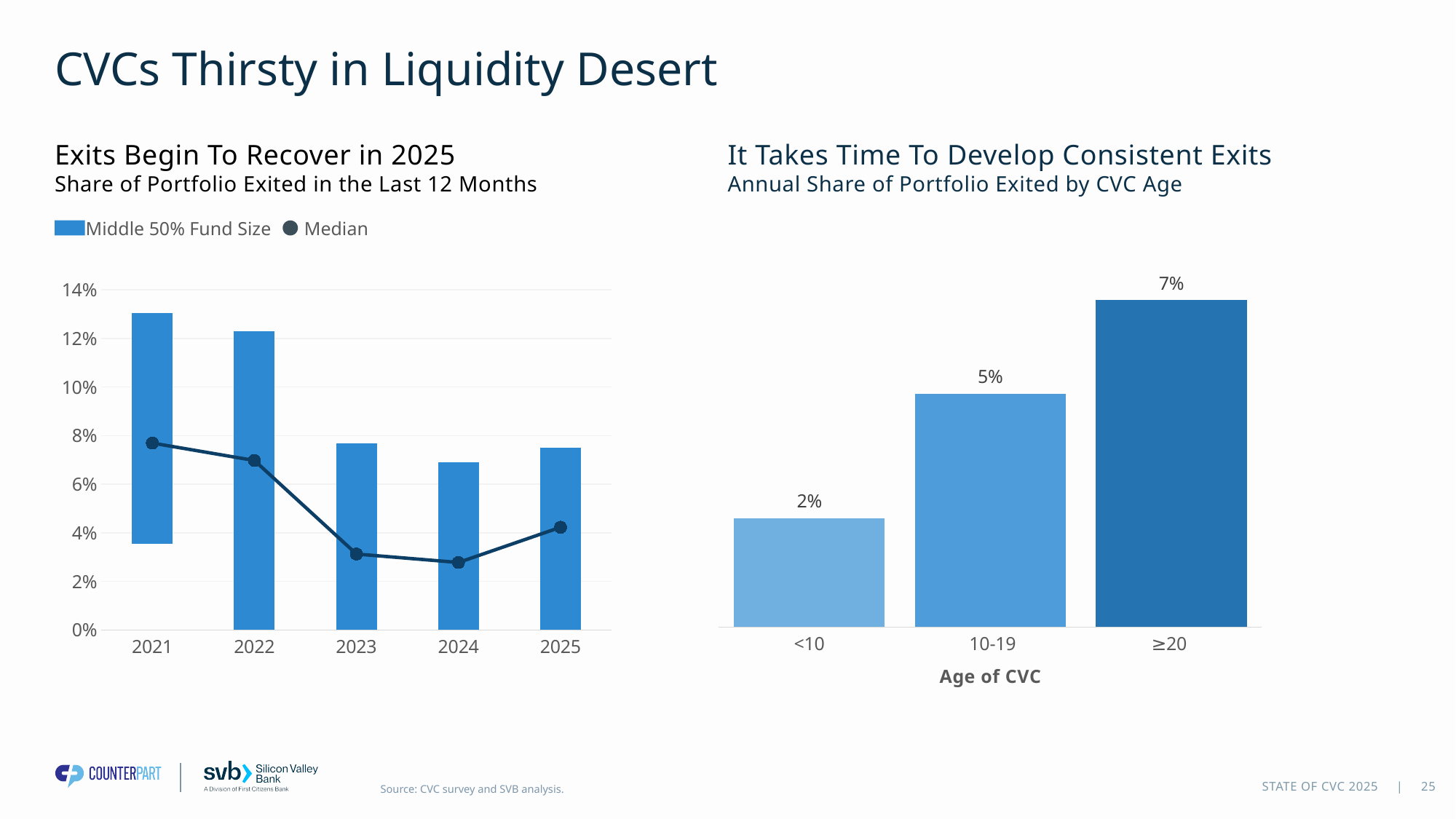
In the chart titled "It Takes Time To Develop Consistent Exits", what is the value for CVCs aged <10? 2% In the chart titled "Exits Begin To Recover in 2025", how many series does the legend list? 2 In the chart titled "It Takes Time To Develop Consistent Exits", which CVC age group has the highest annual share of portfolio exited? ≥20 In the chart titled "Exits Begin To Recover in 2025", does the median rise or fall from 2021 to 2024? Fall In the chart titled "Exits Begin To Recover in 2025", is the median value for 2024 greater or less than 4%? less In the chart titled "It Takes Time To Develop Consistent Exits", which CVC age group has the lowest annual share of portfolio exited? <10 In the chart titled "It Takes Time To Develop Consistent Exits", what is the annual share of portfolio exited for CVCs aged 10-19? 5% In the chart titled "Exits Begin To Recover in 2025", is the median value for 2021 greater or less than 6%? greater What kind of chart is the one titled "It Takes Time To Develop Consistent Exits"? Bar chart In the chart titled "It Takes Time To Develop Consistent Exits", what is the difference between the values for the ≥20 and <10 age groups? 5% In the chart titled "It Takes Time To Develop Consistent Exits", how many CVC age groups are shown? 3 In the chart titled "Exits Begin To Recover in 2025", how many years are shown on the x axis? 5